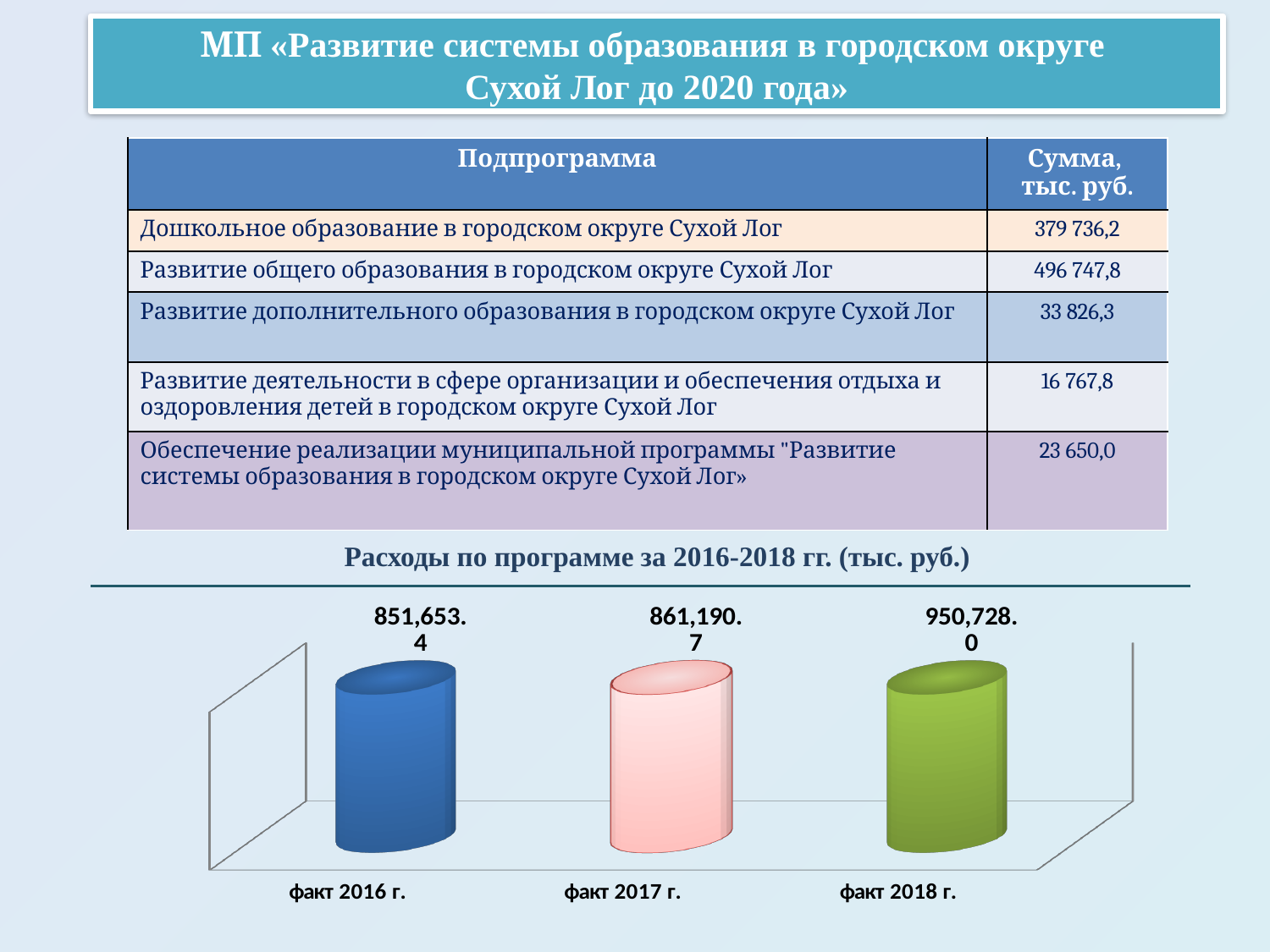
How many categories are shown in the chart? 3 What is the value for факт 2017 г. in the chart? 861,190.7 What is the difference between the values for факт 2018 г. and факт 2016 г.? 99,074.6 Which category has the highest value in the chart? факт 2018 г. What is the difference between the values for факт 2018 г. and факт 2017 г.? 89,537.3 Which category has the lowest value in the chart? факт 2016 г. What kind of chart is shown on the slide? bar chart What is the title of the chart on the slide? Расходы по программе за 2016-2018 гг. (тыс. руб.) Which is larger, the value for факт 2017 г. or факт 2016 г.? факт 2017 г. What is the value for факт 2016 г. in the chart «Расходы по программе за 2016-2018 гг. (тыс. руб.)»? 851,653.4 What is the value for факт 2018 г. in the chart? 950,728.0 Do the values rise or fall from факт 2016 г. to факт 2018 г.? rise